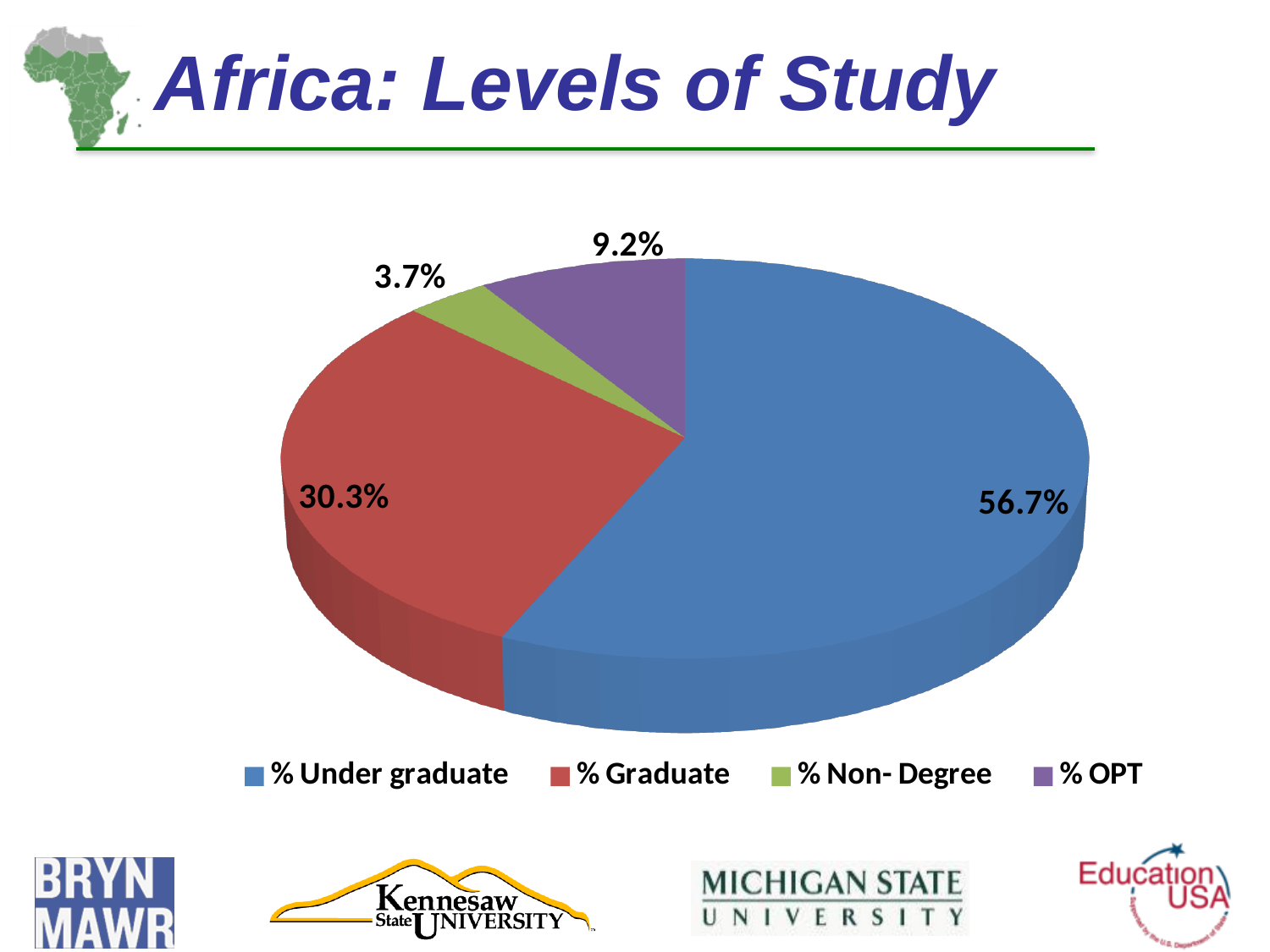
What colour is the % Graduate slice? Red What percentage of the pie is % OPT? 9.2% What percentage of the pie is % Under graduate? 56.7% Which is larger, % OPT or % Non- Degree? % OPT What is the title of the slide containing the chart? Africa: Levels of Study What percentage of the pie is % Graduate? 30.3% Which category has the smallest slice of the pie? % Non- Degree What percentage of the pie is % Non- Degree? 3.7% What kind of chart is shown on the slide? Pie chart How many slices does the pie chart have? 4 What is the difference in percentage points between % Under graduate and % Graduate? 26.4 Which category has the largest slice of the pie? % Under graduate